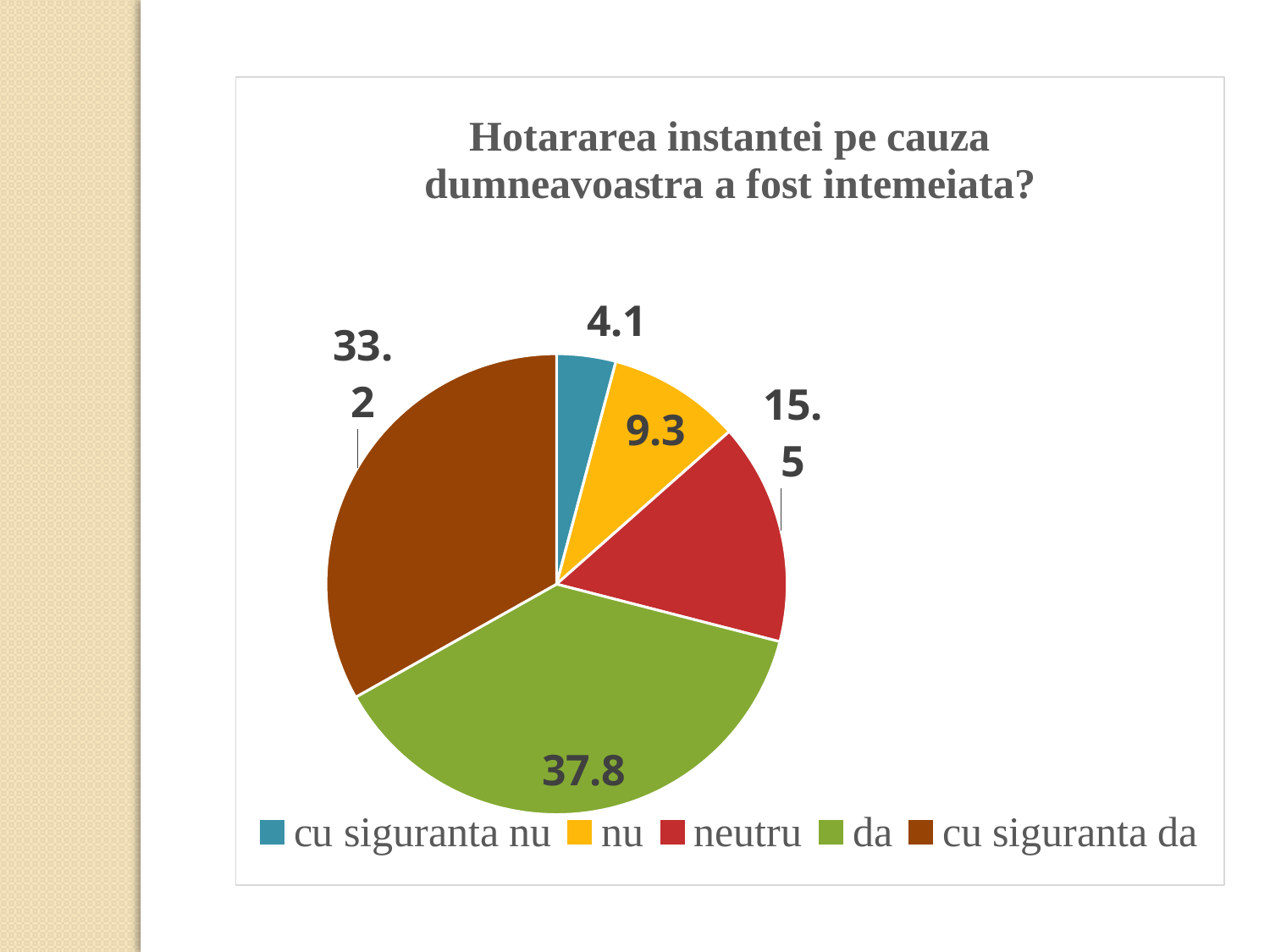
What is the value for "cu siguranta da"? 33.2 What is the difference between the values for "da" and "cu siguranta da"? 4.6 What is the value for "neutru"? 15.5 What is the value for "da"? 37.8 What kind of chart is shown on the slide? pie chart How many categories does the pie chart have? 5 What is the title of the chart? Hotararea instantei pe cauza dumneavoastra a fost intemeiata? Which is larger, the value for "neutru" or the value for "nu"? neutru Which category has the largest slice? da What is the value for "nu"? 9.3 What is the value for "cu siguranta nu"? 4.1 Which category has the smallest slice? cu siguranta nu